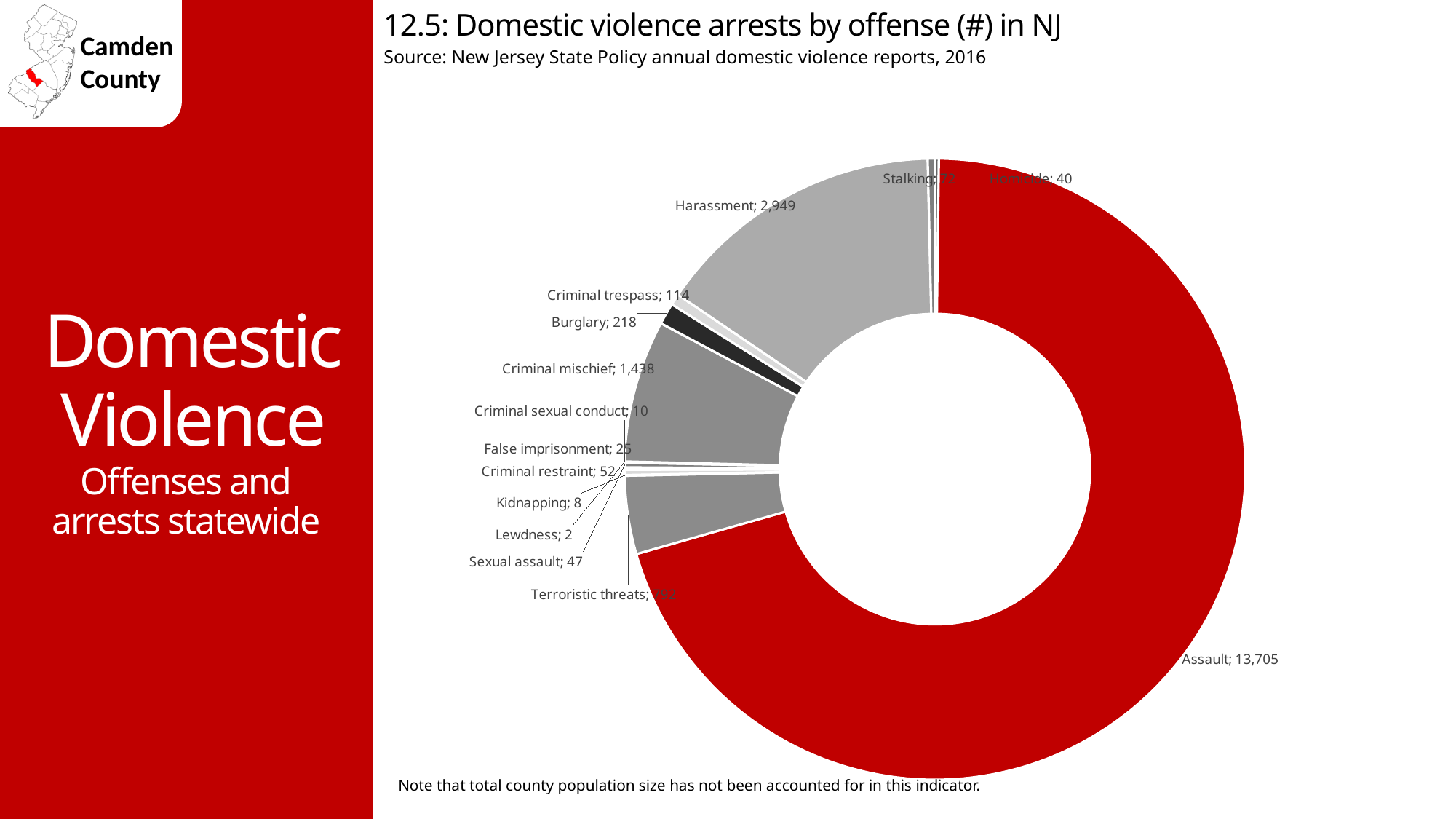
How many arrests are shown for Burglary? 218 What is the value shown for Kidnapping? 8 What type of chart is used on this slide? Pie chart (donut) What is the title of the chart? 12.5: Domestic violence arrests by offense (#) in NJ How many offense categories are shown on the chart? 14 Which offense has the largest number of arrests? Assault How many domestic violence arrests for Assault are shown on the chart? 13,705 What is the difference between the arrests for Harassment and Criminal mischief? 1,511 Which offense has the smallest number of arrests? Lewdness What value is shown for Criminal mischief? 1,438 What is the number of arrests for Harassment? 2,949 Which has more arrests, Burglary or Criminal trespass? Burglary